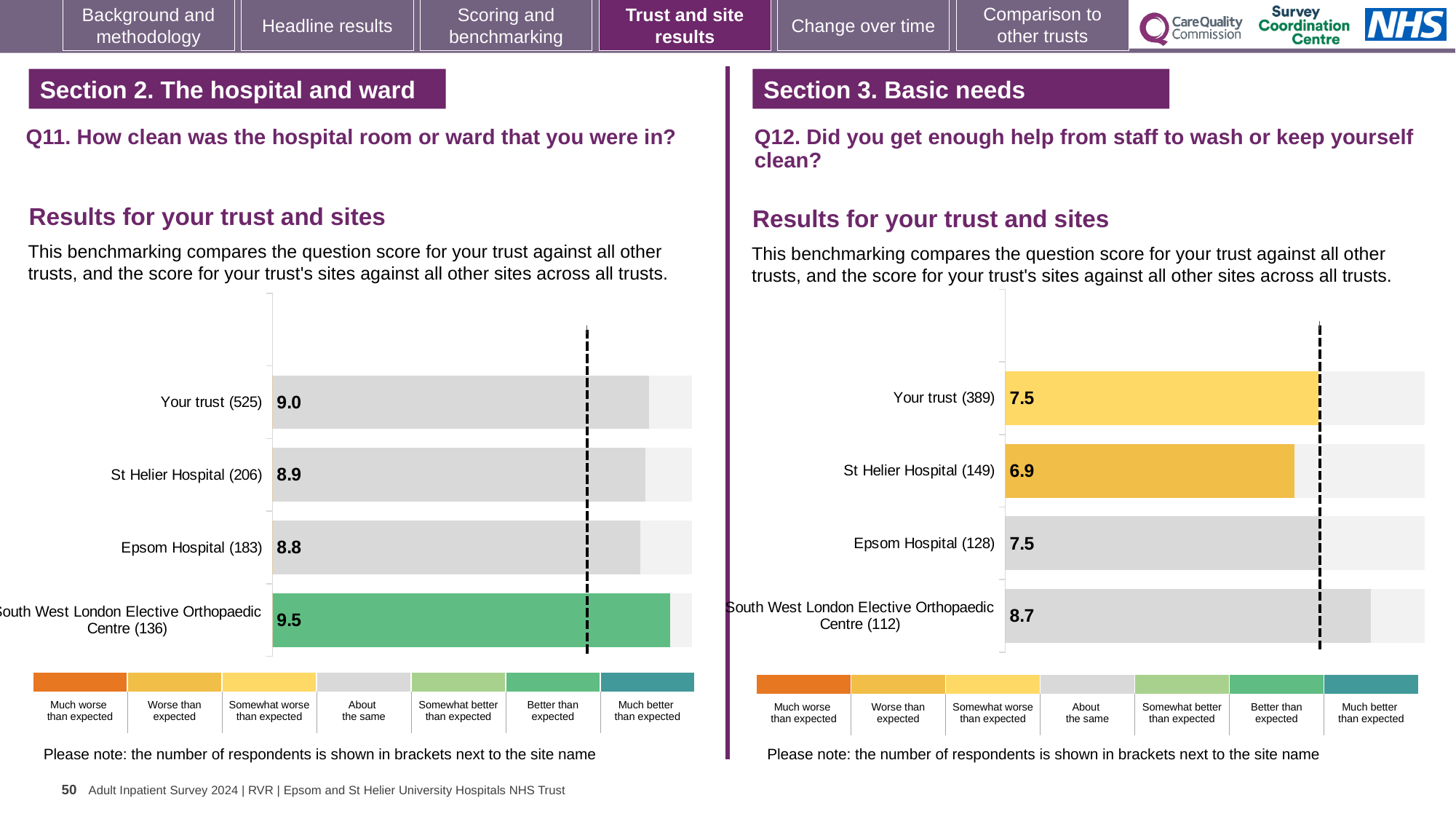
In the Q11 chart on the left, how many respondents are shown in brackets for St Helier Hospital? 206 In the Q11 chart on the left, which site has the highest score? South West London Elective Orthopaedic Centre In the Q12 chart on the right, what is the score for South West London Elective Orthopaedic Centre? 8.7 What type of chart is used for the Q11 results on the left? Bar chart In the Q12 chart on the right, what is the score for St Helier Hospital? 6.9 In the Q12 chart on the right, which site has the lowest score? St Helier Hospital How many bars are plotted in the Q12 chart on the right? 4 In the Q12 chart on the right, which is larger: the score for Your trust or the score for St Helier Hospital? Your trust In the Q11 chart on the left, what is the score for Epsom Hospital? 8.8 In the Q11 chart on the left, what is the difference between the scores for South West London Elective Orthopaedic Centre and St Helier Hospital? 0.6 In the Q12 chart on the right, what is the difference between the scores for South West London Elective Orthopaedic Centre and Epsom Hospital? 1.2 In the Q11 chart on the left, what is the score for Your trust? 9.0